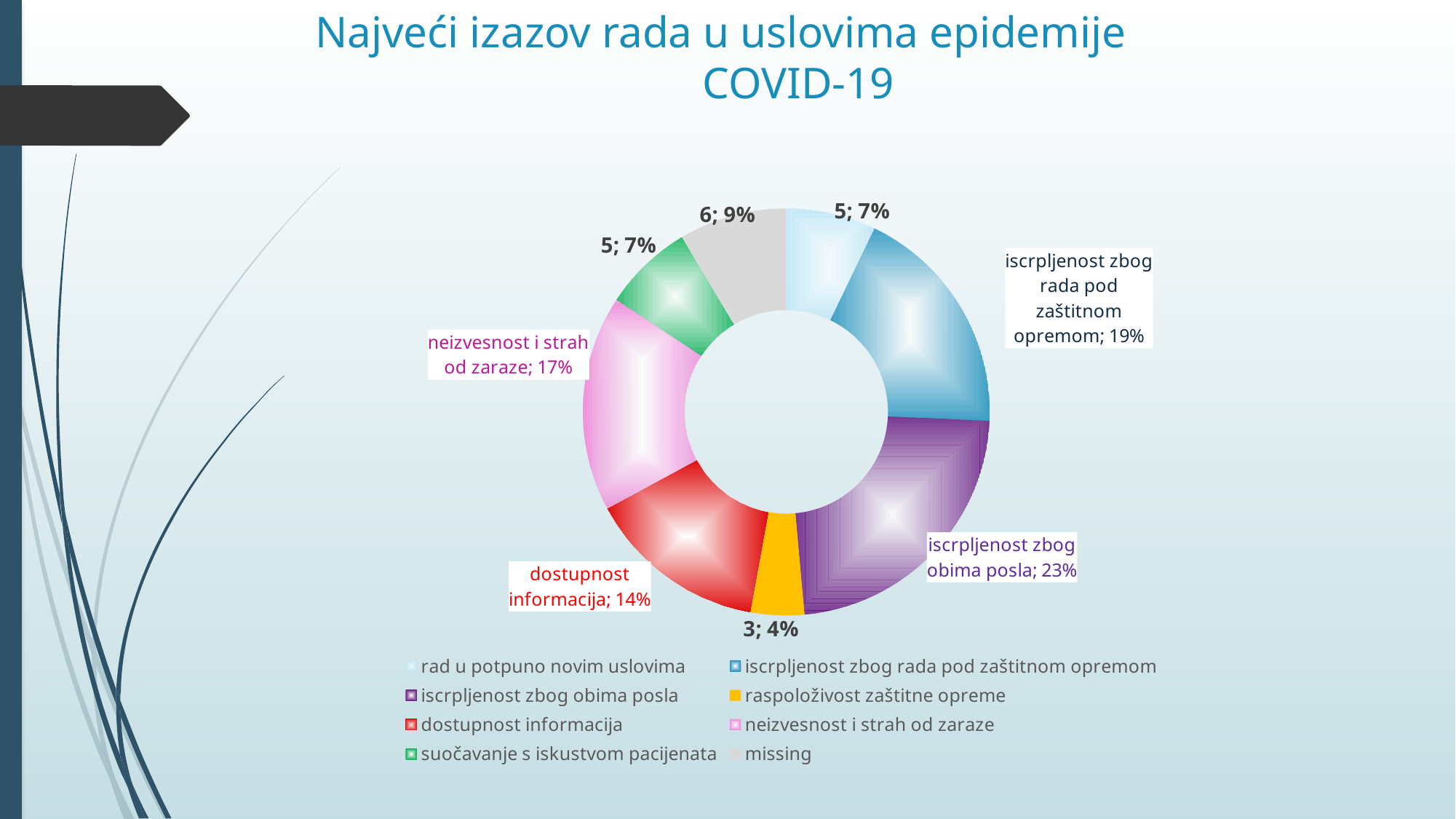
What percentage share is shown for "iscrpljenost zbog rada pod zaštitnom opremom"? 19% What type of chart is shown on the slide? Doughnut (pie) chart Which category has the smallest share of the chart? raspoloživost zaštitne opreme How many categories does the legend list? 8 What percentage share is shown for "iscrpljenost zbog obima posla"? 23% What is the difference in percentage points between "iscrpljenost zbog obima posla" and "dostupnost informacija"? 9 percentage points What percentage share is shown for "neizvesnost i strah od zaraze"? 17% What percentage share is shown for "dostupnost informacija"? 14% What count and percentage are shown for the "raspoloživost zaštitne opreme" (yellow) slice? 3; 4% Which category has the largest share of the chart? iscrpljenost zbog obima posla What count and percentage are shown for the "missing" (grey) slice? 6; 9% Which is larger: the share for "neizvesnost i strah od zaraze" or for "iscrpljenost zbog rada pod zaštitnom opremom"? iscrpljenost zbog rada pod zaštitnom opremom